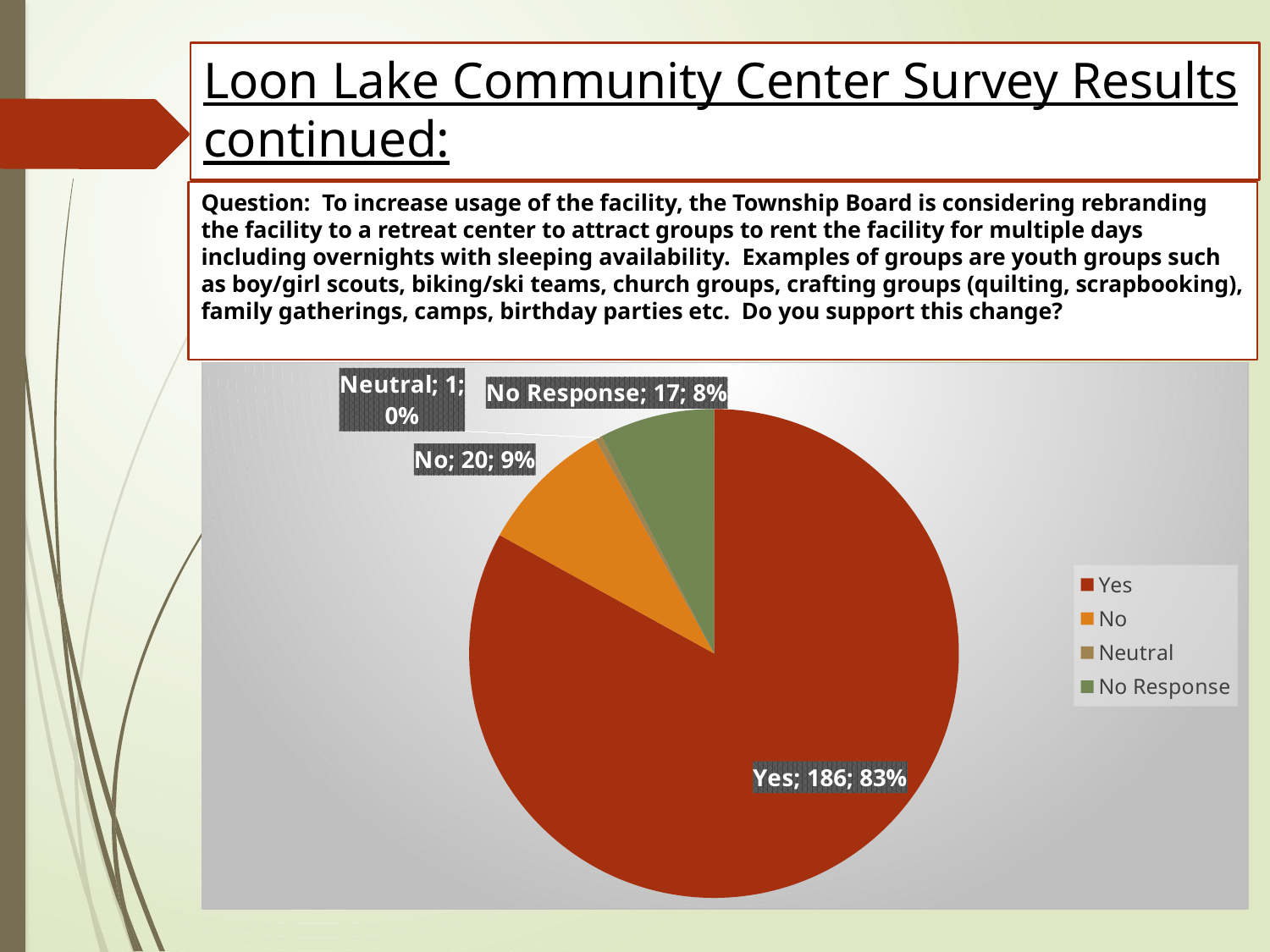
Which category has the largest slice? Yes Which has more responses, No or No Response? No What share of the pie does the Yes slice represent? 83% How many categories does the legend list? 4 Which category has the smallest slice? Neutral What share of the pie does the No slice represent? 9% How many responses are in the No Response slice? 17 How many responses are in the Neutral slice? 1 How many responses are in the No slice? 20 What is the difference between the number of Yes responses and No responses? 166 How many responses are in the Yes slice? 186 What kind of chart is shown on the slide? pie chart